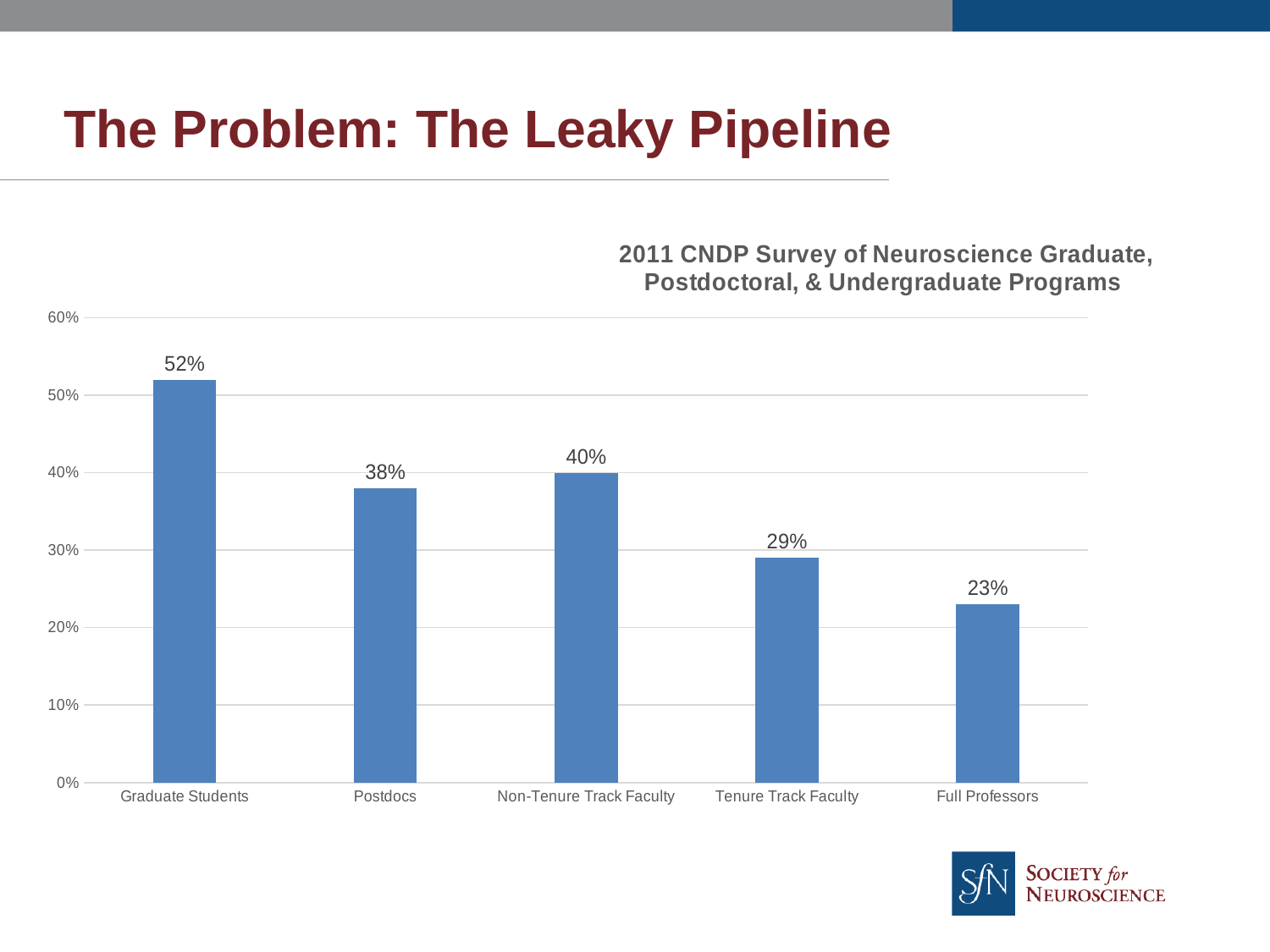
How many categories are shown on the x axis? 5 What is the title of the chart? 2011 CNDP Survey of Neuroscience Graduate, Postdoctoral, & Undergraduate Programs Which is larger, the value for Postdocs or the value for Non-Tenure Track Faculty? Non-Tenure Track Faculty Which category has the lowest value? Full Professors Which category has the highest value? Graduate Students What kind of chart is shown on the slide? bar chart What is the value for Graduate Students? 52% Is the value for Tenure Track Faculty greater or less than 30%? less What is the value for Tenure Track Faculty? 29% What is the difference between the values for Graduate Students and Full Professors? 29% What is the value for Full Professors? 23% What is the value for Postdocs? 38%